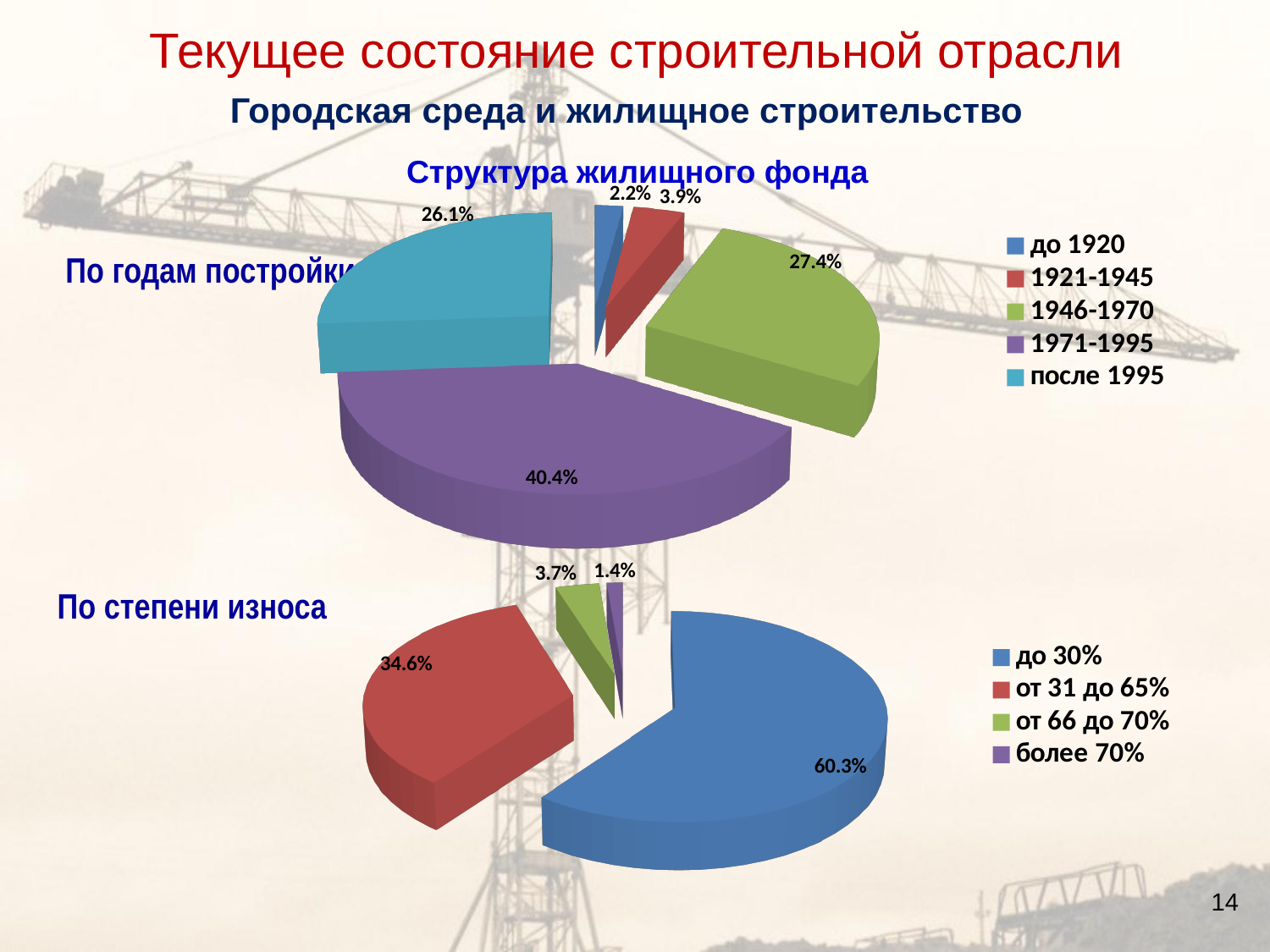
How many categories does the legend of the top pie chart (По годам постройки) list? 5 In the top pie chart (По годам постройки), what is the difference between the shares for 1946-1970 and 1921-1945? 23.5% In the top pie chart (По годам постройки), what share of the housing stock was built in 1971-1995? 40.4% In the bottom pie chart (По степени износа), which category has the largest share? до 30% In the top pie chart (По годам постройки), which period has the smallest share? до 1920 In the bottom pie chart (По степени износа), what share has wear of more than 70% (более 70%)? 1.4% In the bottom pie chart (По степени износа), what share has wear of up to 30% (до 30%)? 60.3% In the bottom pie chart (По степени износа), which is larger: от 31 до 65% or от 66 до 70%? от 31 до 65% In the top pie chart (По годам постройки), what share was built after 1995 (после 1995)? 26.1% In the top pie chart (По годам постройки), which period has the largest share? 1971-1995 What type of chart is used for the two charts on the slide? Pie chart In the bottom pie chart (По степени износа), what is the difference between the shares for до 30% and от 31 до 65%? 25.7%